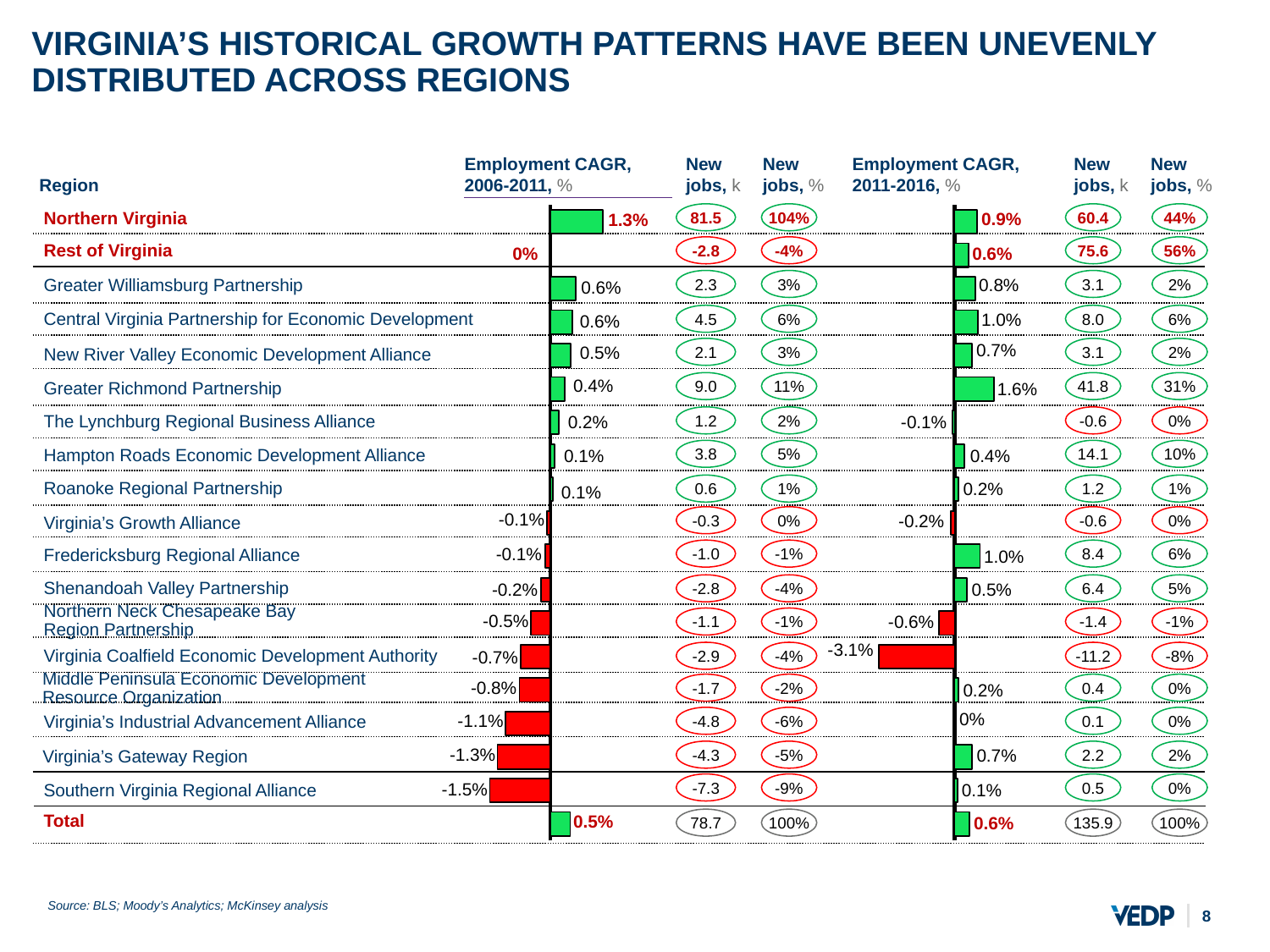
In the Employment CAGR 2011-2016 chart, what is the value for Greater Richmond Partnership? 1.6% What kind of chart is used to show the Employment CAGR values on the slide? Bar chart In the Employment CAGR 2006-2011 chart, what is the value for Northern Virginia? 1.3% In the Employment CAGR 2006-2011 chart, which region has the lowest value? Southern Virginia Regional Alliance In the Employment CAGR 2006-2011 chart, what is the value for Virginia Coalfield Economic Development Authority? -0.7% In the Employment CAGR 2011-2016 chart, which region has the highest value? Greater Richmond Partnership In the Employment CAGR 2011-2016 chart, which region has the lowest value? Virginia Coalfield Economic Development Authority For Hampton Roads Economic Development Alliance, which period has the larger Employment CAGR, 2006-2011 or 2011-2016? 2011-2016 In the Employment CAGR charts, what colour are the bars for negative values? Red In the Employment CAGR 2011-2016 chart, what is the value for Total? 0.6% In the Employment CAGR 2006-2011 chart, what is the value for Greater Richmond Partnership? 0.4% What is the difference between Northern Virginia's Employment CAGR for 2006-2011 and for 2011-2016? 0.4 percentage points